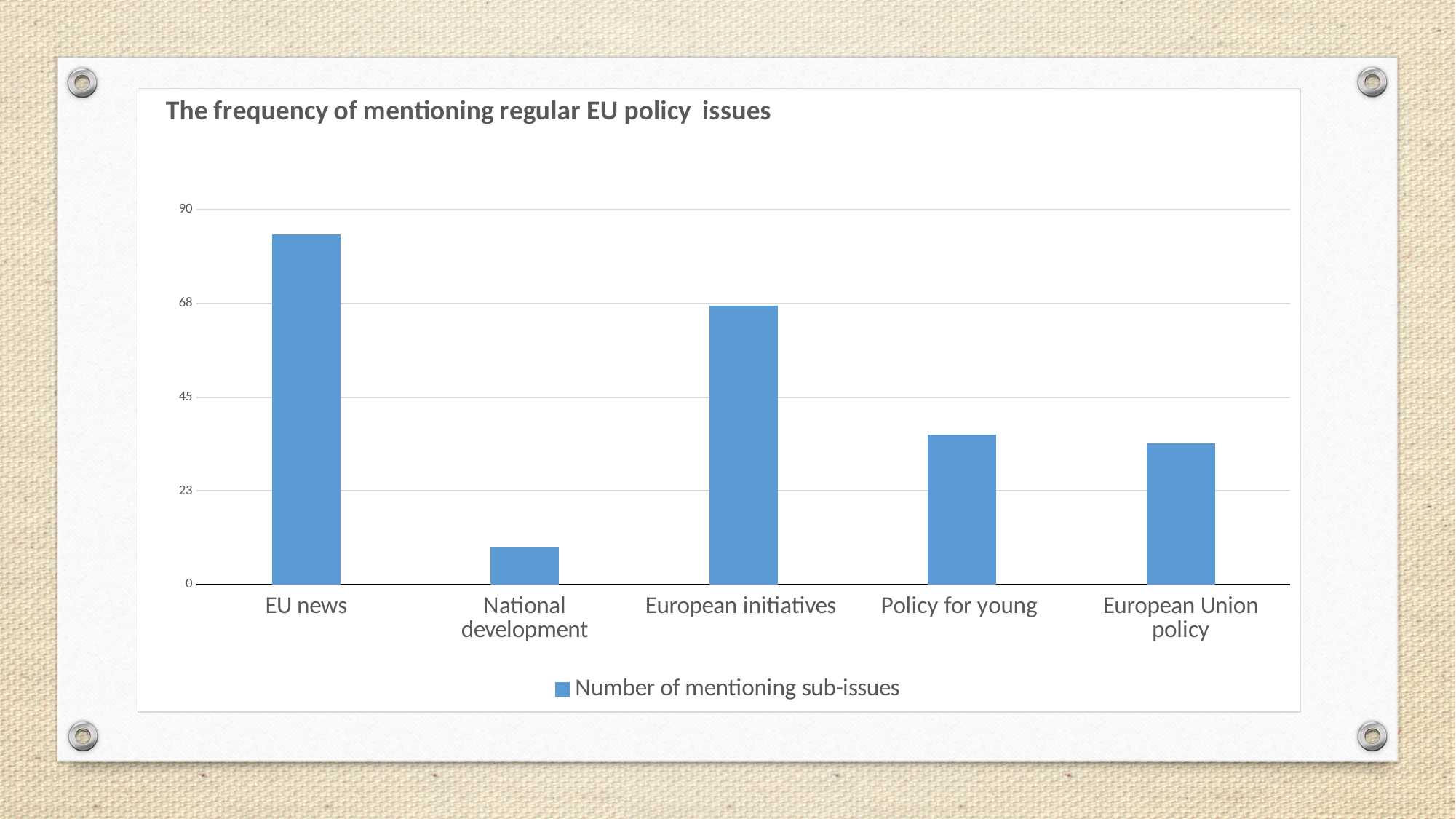
What type of chart is shown on the slide? bar chart Which is larger, the value for EU news or the value for European initiatives? EU news Is the value for Policy for young greater or less than 45? less Is the value for National development greater or less than 23? less How many series does the legend list? 1 How many categories are shown on the x axis of the chart? 5 Is the value for European Union policy greater or less than 23? greater Which category has the lowest value? National development What is the title of the chart? The frequency of mentioning regular EU policy issues What is the name of the series shown in the legend? Number of mentioning sub-issues Which category has the highest value? EU news